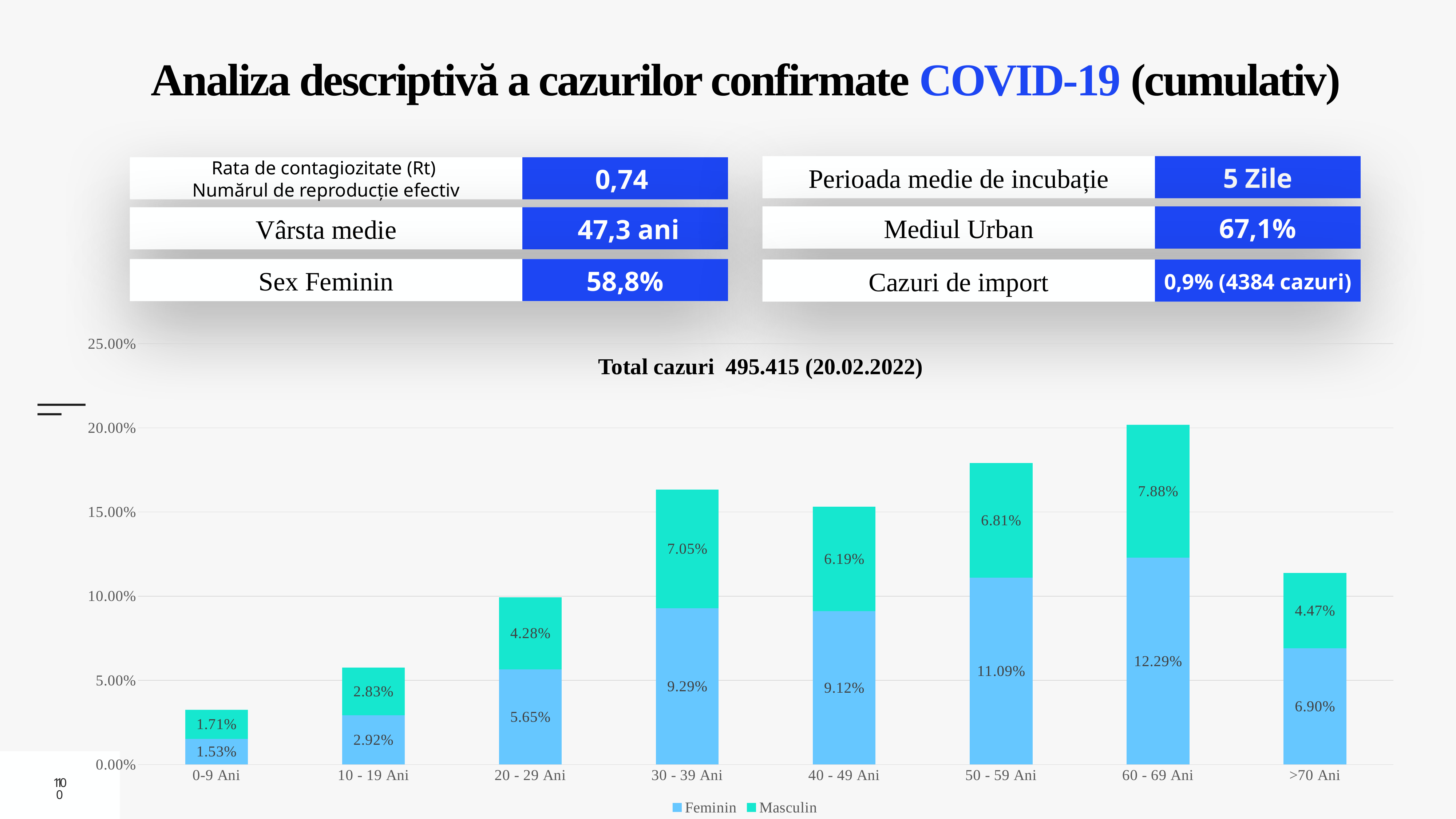
What is the total of the stacked bar for the 60 - 69 Ani age group? 20.17% Which age group has the highest Feminin value? 60 - 69 Ani What is the Feminin value for the >70 Ani age group? 6.90% Is the total stacked bar for the 40 - 49 Ani age group greater or less than 15.00%? greater Which age group has the lowest Masculin value? 0-9 Ani What kind of chart is shown on the slide? Stacked bar chart What is the difference between the Feminin and Masculin values for the 50 - 59 Ani age group? 4.28% How many age groups are shown on the x axis of the chart? 8 Which is larger for the 20 - 29 Ani age group, the Feminin value or the Masculin value? Feminin How many series does the chart legend list? 2 What is the Feminin value for the 60 - 69 Ani age group? 12.29% What is the Masculin value for the 30 - 39 Ani age group? 7.05%